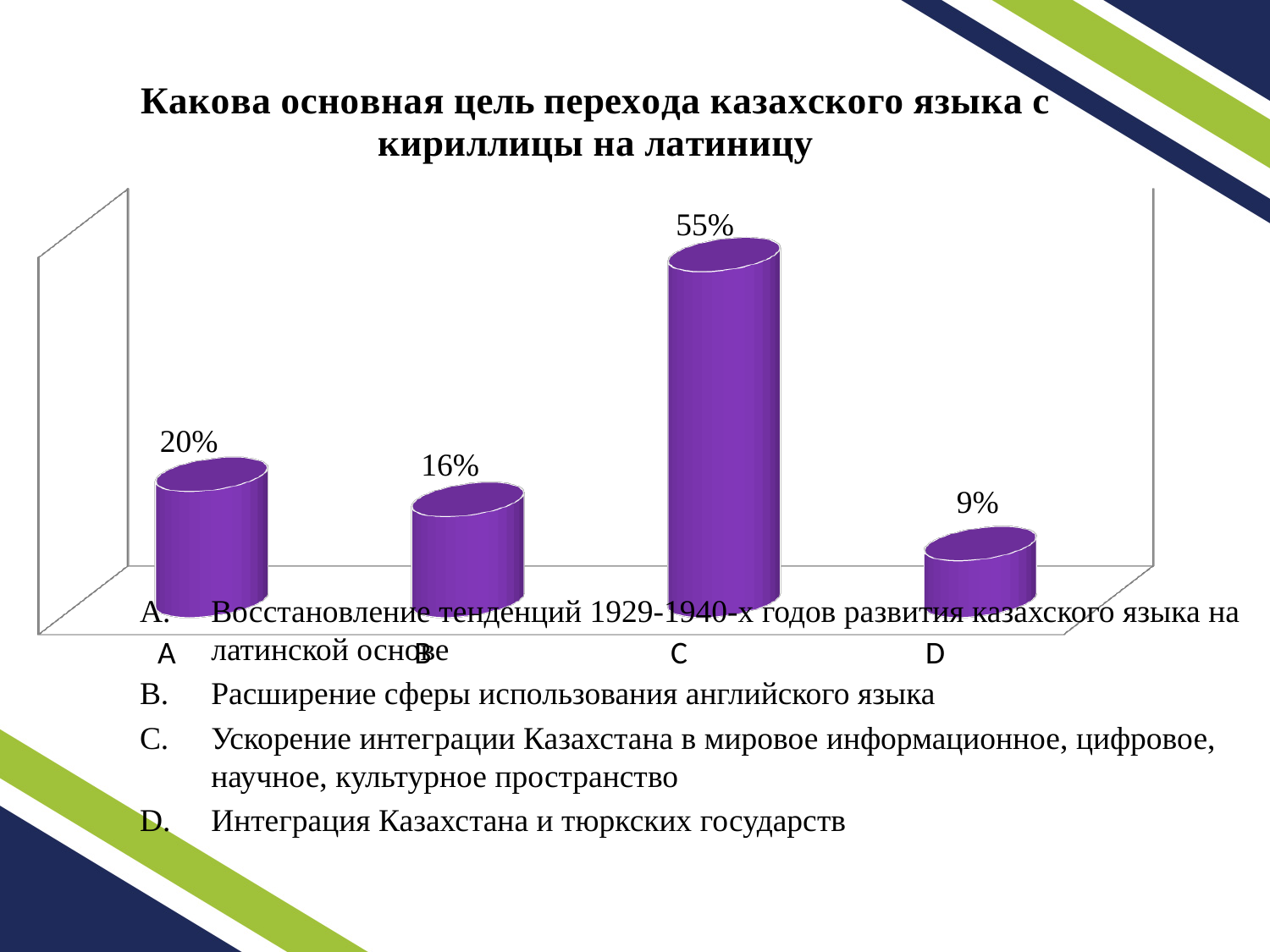
What is the value for category C? 55% What is the value for category B? 16% Which category has the lowest value? D What is the value for category D? 9% Which category has the highest value? C What is the difference between the values for C and A? 35% How many categories are shown in the chart? 4 What kind of chart is shown on the slide? Bar chart What is the value for category A? 20% What is the title of the chart? Какова основная цель перехода казахского языка с кириллицы на латиницу Which is larger, the value for A or the value for D? A What is the difference between the values for A and B? 4%